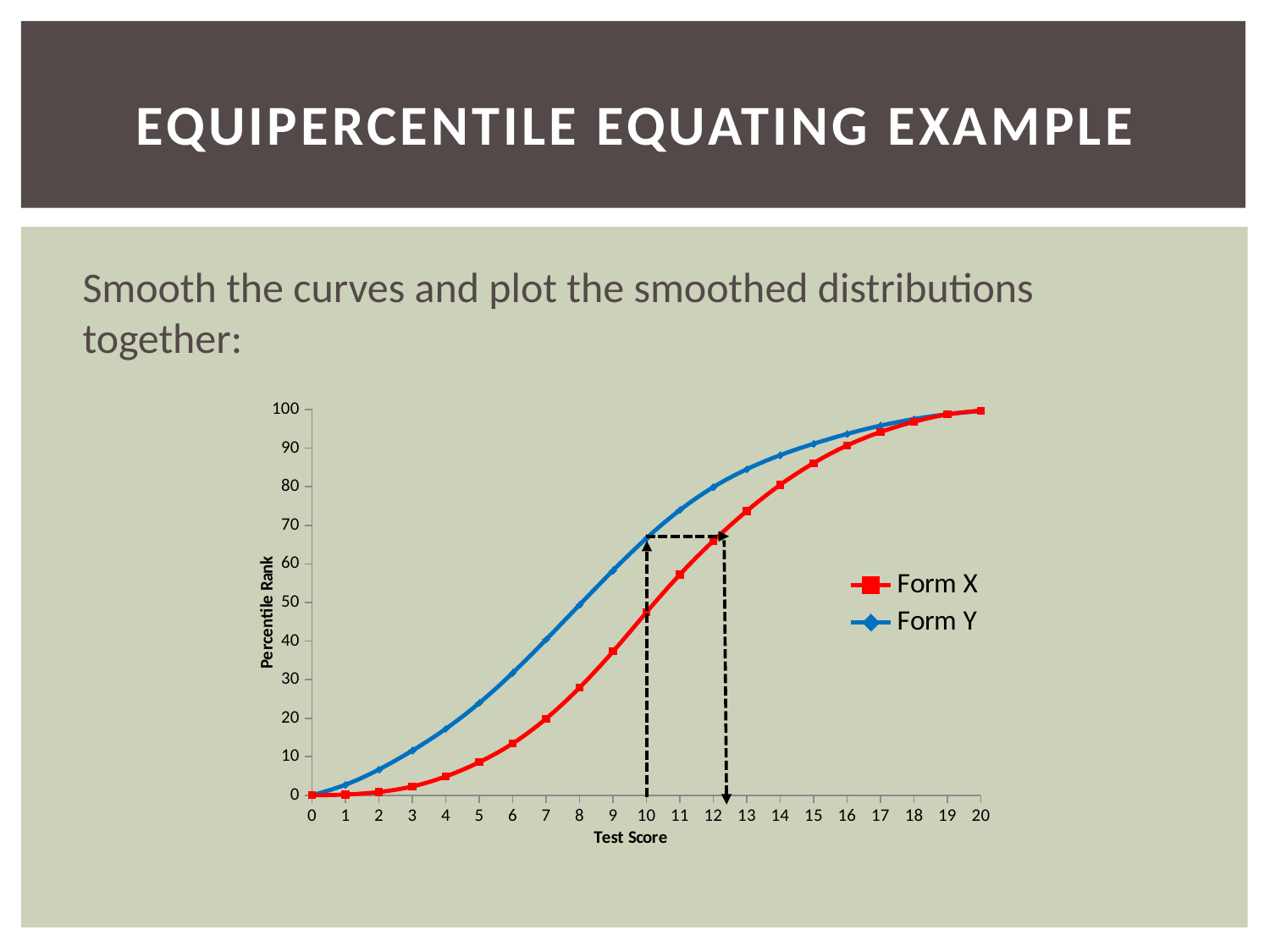
Is the Form X percentile rank at a test score of 10 greater or less than 50? less What is the title of the x axis? Test Score Do the percentile rank values for Form X rise or fall as the test score increases? rise How many series does the legend list? 2 Is the Form Y percentile rank at a test score of 5 greater or less than 20? greater What kind of chart is shown on the slide? line chart At a test score of 8, which series has the higher percentile rank, Form X or Form Y? Form Y Is the Form Y percentile rank at a test score of 10 greater or less than 60? greater What is the percentile rank for Form X at a test score of 0? 0 What are the names of the two series in the legend? Form X and Form Y How many test score points are plotted along the x axis for each series? 21